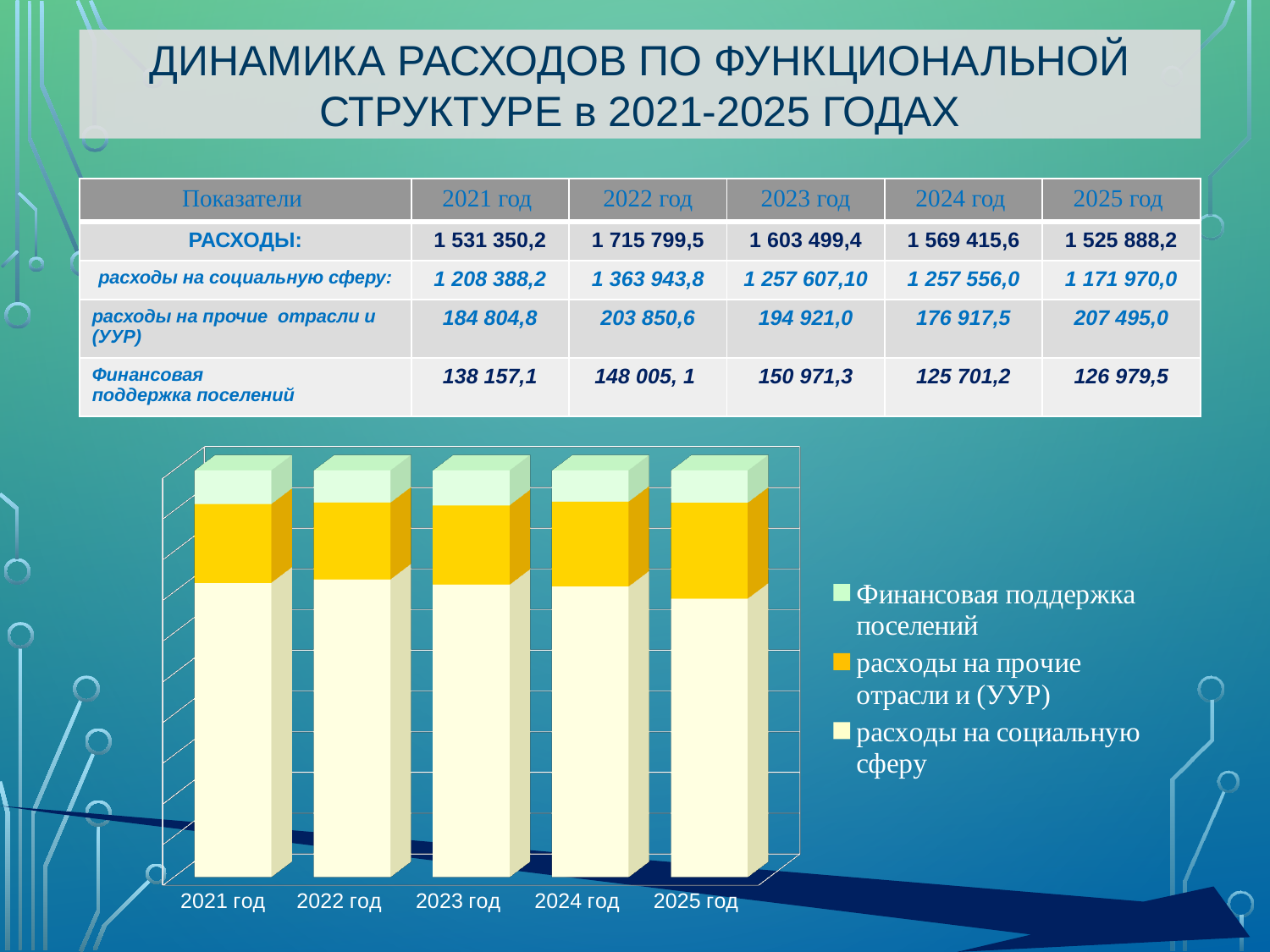
In which year are total РАСХОДЫ the highest? 2022 год How many series does the chart legend list? 3 Which is larger, Финансовая поддержка поселений in 2023 год or in 2024 год? 2023 год What is the value of расходы на социальную сферу for 2022 год? 1 363 943,8 What kind of chart is shown at the bottom of the slide? Stacked bar chart What is the value of расходы на прочие отрасли и (УУР) for 2025 год? 207 495,0 Do расходы на социальную сферу rise or fall from 2022 год to 2025 год? Fall In which year is Финансовая поддержка поселений the highest? 2023 год In which year are total РАСХОДЫ the lowest? 2025 год Which series is shown in light green in the chart? Финансовая поддержка поселений Which series forms the bottom (largest) segment of each stacked bar? расходы на социальную сферу How many years (categories) are plotted along the x axis of the chart? 5